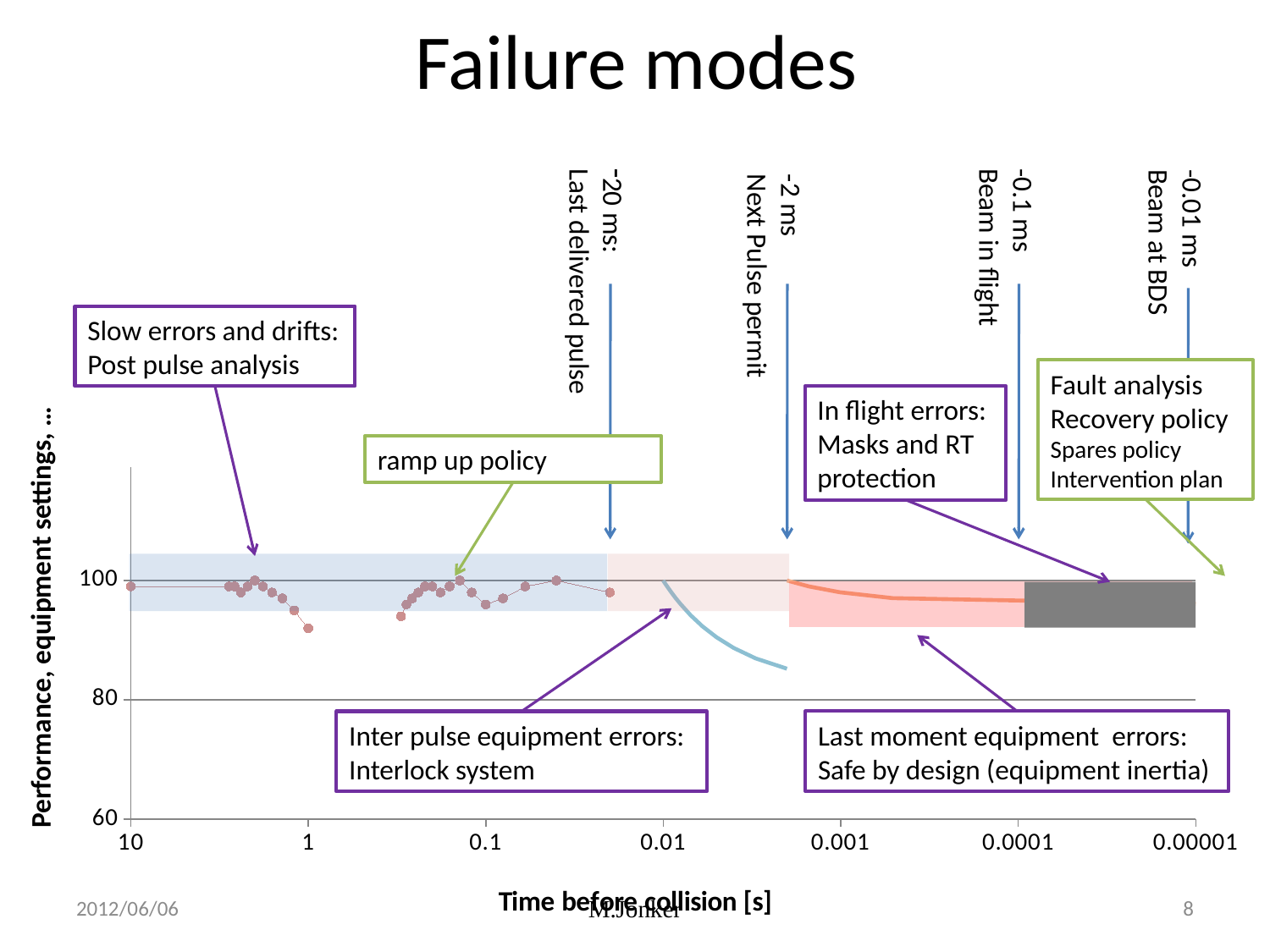
Is the lower end of the blue curve (between x = 0.01 and x = 0.001) greater or less than 80? greater How many tick labels are shown on the y axis of the chart? 3 Is the lowest point of the dotted data series (near x = 1) greater or less than 100? less What is the title of the y axis of the chart? Performance, equipment settings, ... Do the x-axis tick values increase or decrease from left to right? decrease Is the lowest point of the dotted data series (near x = 1) greater or less than 80? greater What is the leftmost tick value on the x axis? 10 What kind of chart is shown on the slide? line chart What is the title of the x axis of the chart? Time before collision [s] What is the highest tick value shown on the y axis? 100 What is the rightmost tick value on the x axis? 0.00001 How many tick labels are shown on the x axis of the chart? 7